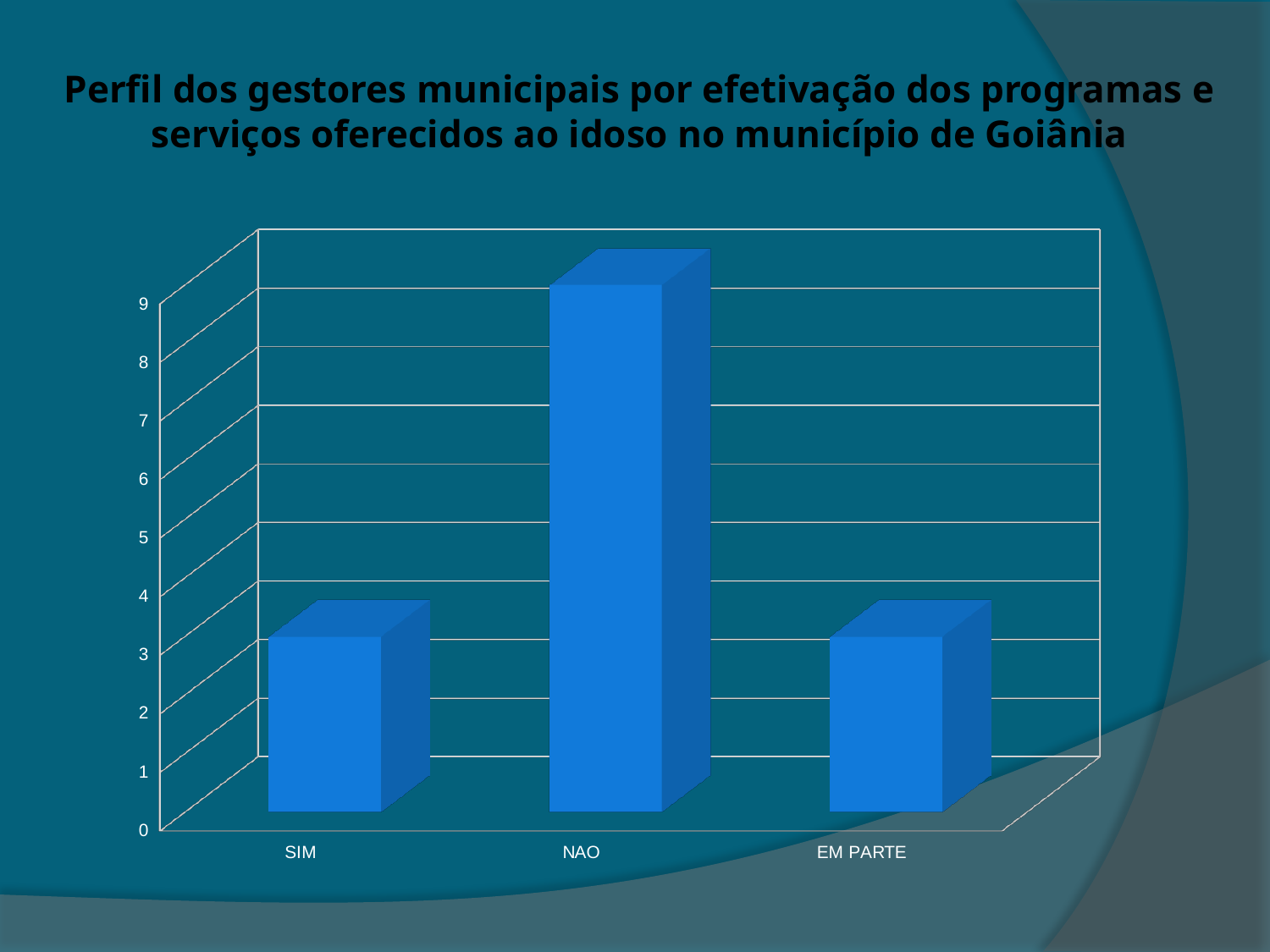
Is the value for EM PARTE greater or less than 5? less Is the value for NAO greater or less than 5? greater What is the highest value shown on the vertical axis of the chart? 9 Is the value for SIM greater or less than 5? less Which is larger, the value for NAO or the value for SIM? NAO What is the title of the slide containing the chart? Perfil dos gestores municipais por efetivação dos programas e serviços oferecidos ao idoso no município de Goiânia Which category has the highest bar in the chart? NAO Which is larger, the value for EM PARTE or the value for NAO? NAO How many categories are shown on the x axis of the chart? 3 What kind of chart is shown on the slide? bar chart